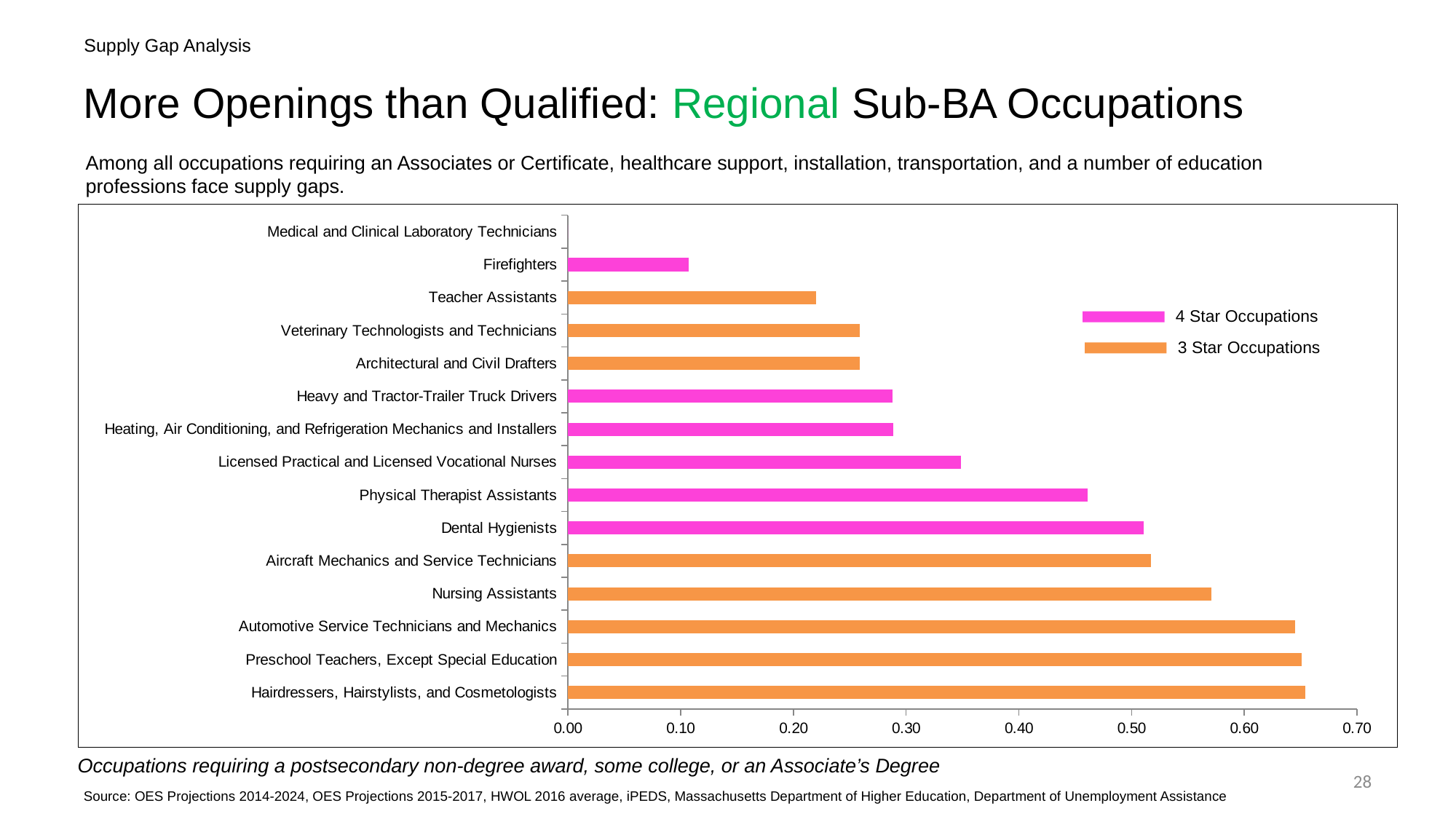
Is the value for Teacher Assistants greater or less than 0.30? less What kind of chart is shown on the slide? bar chart Which is larger, the value for Nursing Assistants or the value for Physical Therapist Assistants? Nursing Assistants Is the value for Physical Therapist Assistants greater or less than 0.40? greater How many occupations are listed on the chart? 15 Is the value for Nursing Assistants greater or less than 0.50? greater How many series does the legend list? 2 Which is larger, the value for Firefighters or the value for Teacher Assistants? Teacher Assistants Which legend series is shown in orange? 3 Star Occupations Which occupation has the lowest value on the chart? Medical and Clinical Laboratory Technicians